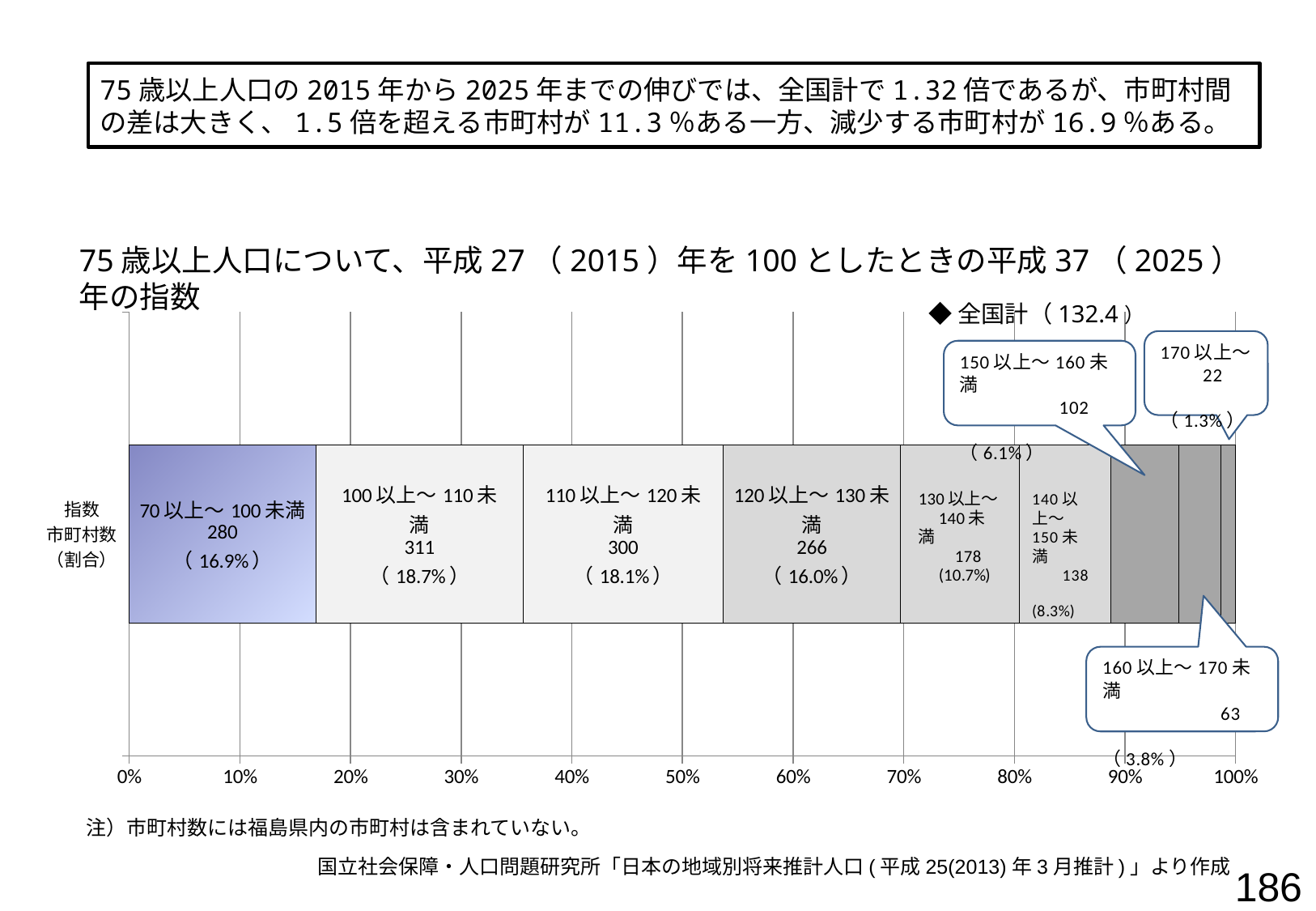
What is the difference in municipality count between the 130以上～140未満 and 140以上～150未満 segments? 40 What percentage is shown for the 160以上～170未満 segment? 3.8% Which has more municipalities, the 110以上～120未満 segment or the 150以上～160未満 segment? 110以上～120未満 How many municipalities are in the 120以上～130未満 segment? 266 What kind of chart is shown on the slide? bar chart How many segments make up the stacked bar? 9 How many municipalities fall in the 70以上～100未満 segment? 280 Which segment has the smallest number of municipalities? 170以上～ What share of municipalities is in the 100以上～110未満 segment? 18.7% Which segment has the largest number of municipalities? 100以上～110未満 What is the national total index (全国計) shown on the chart? 132.4 How many municipalities are in the 170以上～ segment? 22